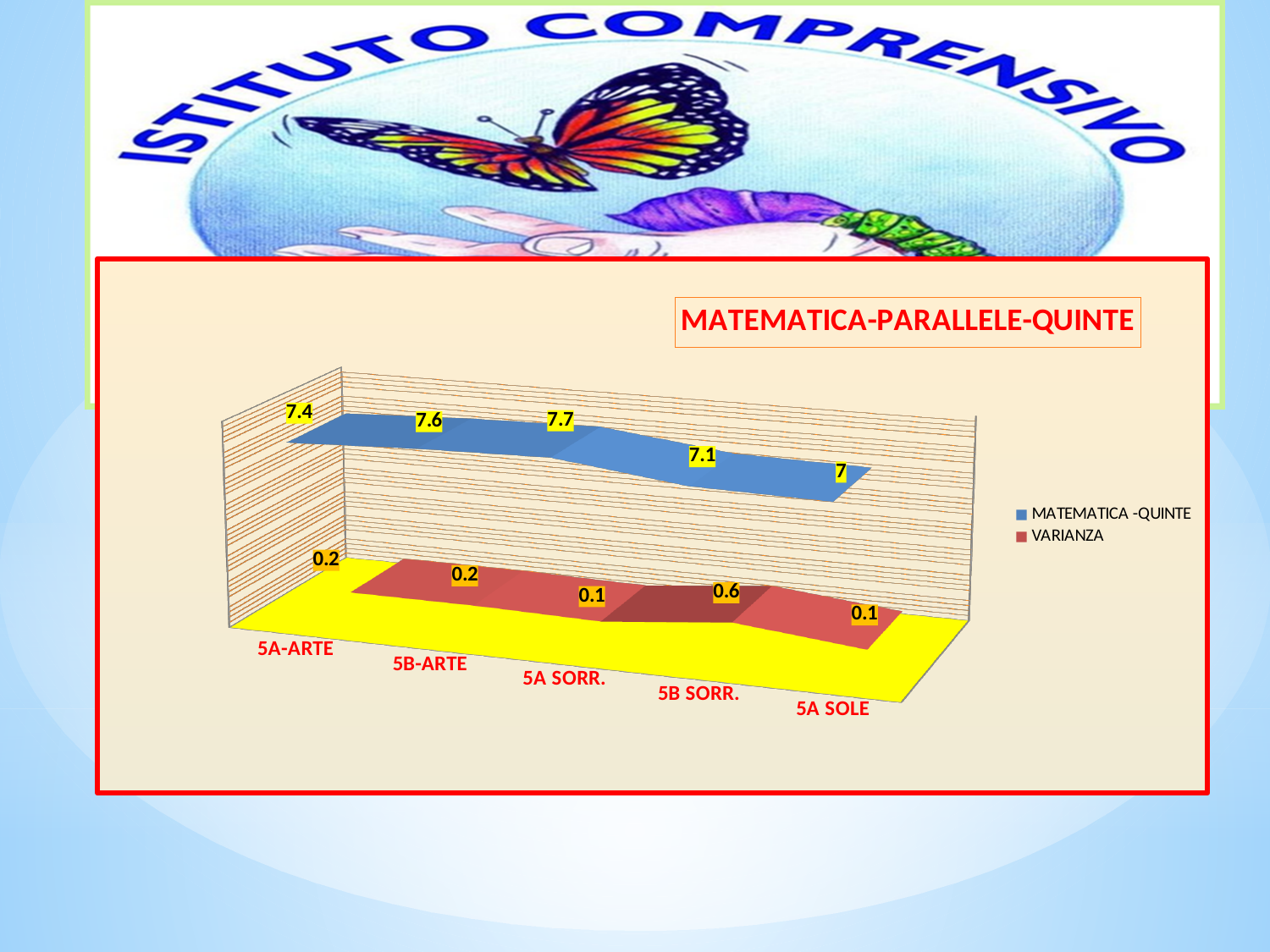
What is the title of the chart? MATEMATICA-PARALLELE-QUINTE What is the MATEMATICA -QUINTE value for 5A SOLE? 7 What is the MATEMATICA -QUINTE value for 5A-ARTE? 7.4 Which category has the highest VARIANZA value? 5B SORR. What is the difference between the MATEMATICA -QUINTE values for 5A SORR. and 5B SORR.? 0.6 What colour represents the VARIANZA series? Red Which category has the lowest MATEMATICA -QUINTE value? 5A SOLE Which is larger, the MATEMATICA -QUINTE value for 5B-ARTE or for 5B SORR.? 5B-ARTE What is the VARIANZA value for 5B SORR.? 0.6 How many categories are shown on the x axis? 5 Which category has the highest MATEMATICA -QUINTE value? 5A SORR. How many series does the legend list? 2